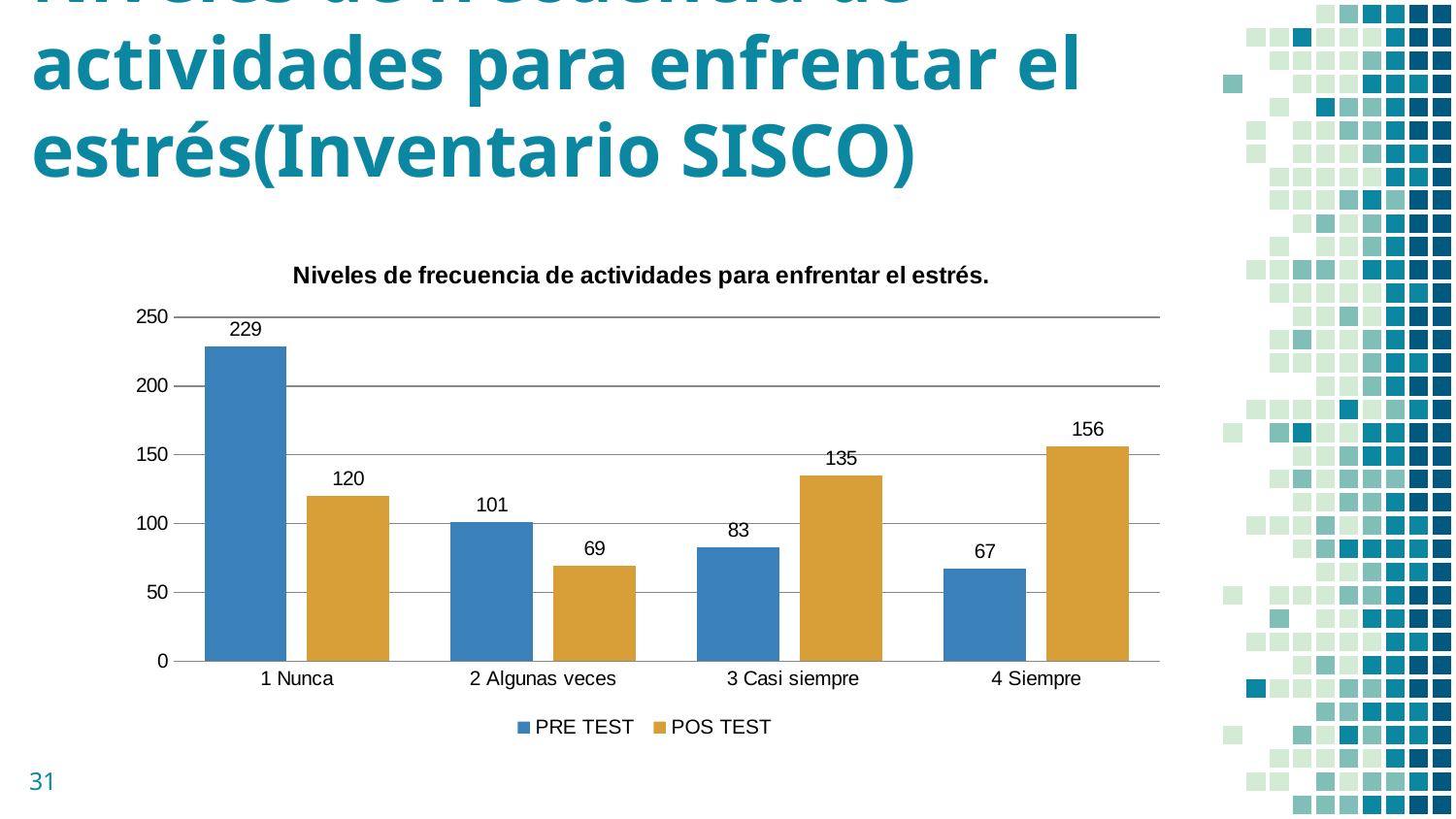
Which category has the highest PRE TEST value? 1 Nunca What is the POS TEST value for 4 Siempre? 156 What kind of chart is shown on the slide? Bar chart Is the PRE TEST value for 2 Algunas veces greater or less than 100? greater Which is larger for 3 Casi siempre, the PRE TEST or the POS TEST value? POS TEST What is the difference between the POS TEST and PRE TEST values for 4 Siempre? 89 What is the difference between the PRE TEST and POS TEST values for 1 Nunca? 109 What is the PRE TEST value for 1 Nunca? 229 How many series does the legend list? 2 How many categories are shown on the x axis? 4 Which category has the lowest POS TEST value? 2 Algunas veces What is the POS TEST value for 2 Algunas veces? 69